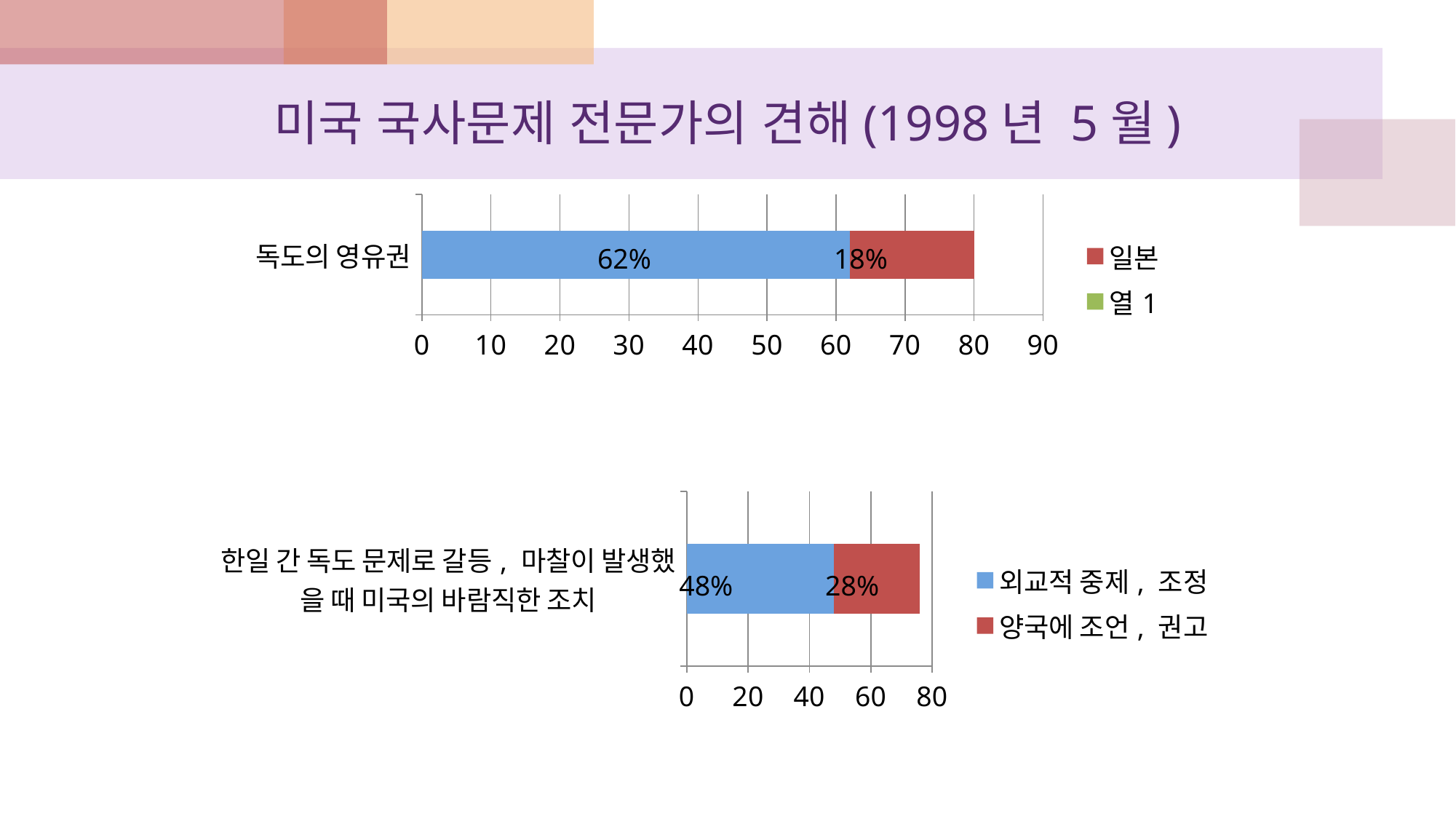
In the top chart, what is the total of the stacked bar for 독도의 영유권? 80% In the bottom chart, what is the value for 외교적 중제, 조정? 48% In the bottom chart, what is the total of the stacked bar for 한일 간 독도 문제로 갈등, 마찰이 발생했을 때 미국의 바람직한 조치? 76% In the bottom chart, what is the value for 양국에 조언, 권고? 28% In the top chart, what value is printed on the blue segment of the 독도의 영유권 bar? 62% In the top chart, which legend entry is shown in red? 일본 In the top chart, what is the value for 일본 in the 독도의 영유권 bar? 18% In the bottom chart, what is the difference between 외교적 중제, 조정 and 양국에 조언, 권고? 20% In the top chart, what is the difference between the blue segment (62%) and the 일본 segment? 44% In the bottom chart, which is larger: 외교적 중제, 조정 or 양국에 조언, 권고? 외교적 중제, 조정 What kind of chart is the top chart? Bar chart How many entries does the legend of the bottom chart list? 2